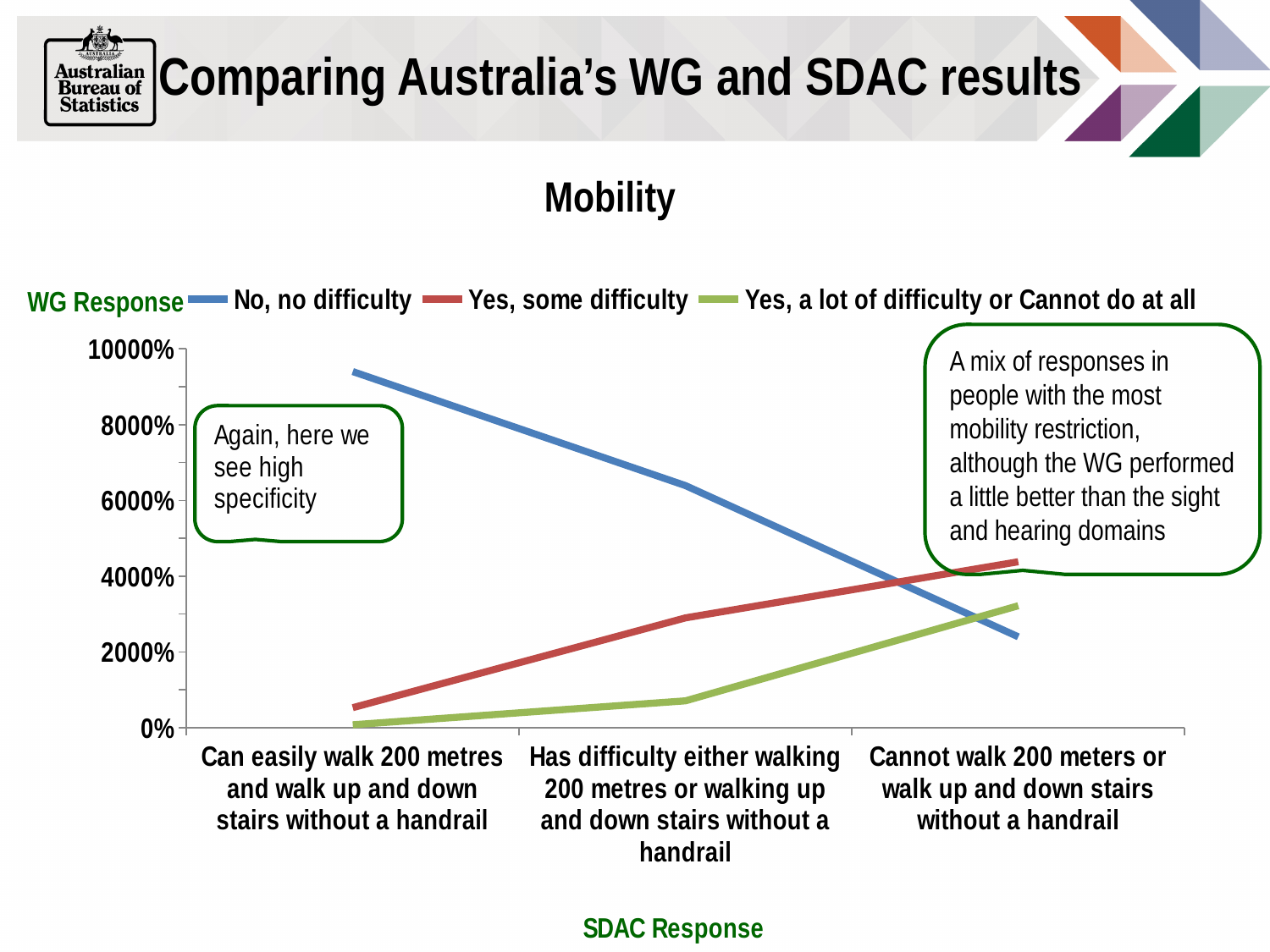
What kind of chart is shown on the slide? Line chart Is the value for 'No, no difficulty' at 'Can easily walk 200 metres and walk up and down stairs without a handrail' greater or less than 8000%? greater What is the title of the chart? Mobility Is the value for 'No, no difficulty' at 'Cannot walk 200 meters or walk up and down stairs without a handrail' greater or less than 4000%? less How many SDAC response categories are shown on the x axis? 3 How many series does the legend list? 3 Does the 'No, no difficulty' line rise or fall from left to right along the x axis? Fall Is the value for 'Yes, a lot of difficulty or Cannot do at all' at 'Has difficulty either walking 200 metres or walking up and down stairs without a handrail' greater or less than 2000%? less Does the 'Yes, some difficulty' line rise or fall from left to right along the x axis? Rise Which series has the highest value at 'Can easily walk 200 metres and walk up and down stairs without a handrail'? No, no difficulty At 'Cannot walk 200 meters or walk up and down stairs without a handrail', which is larger: 'Yes, some difficulty' or 'No, no difficulty'? Yes, some difficulty